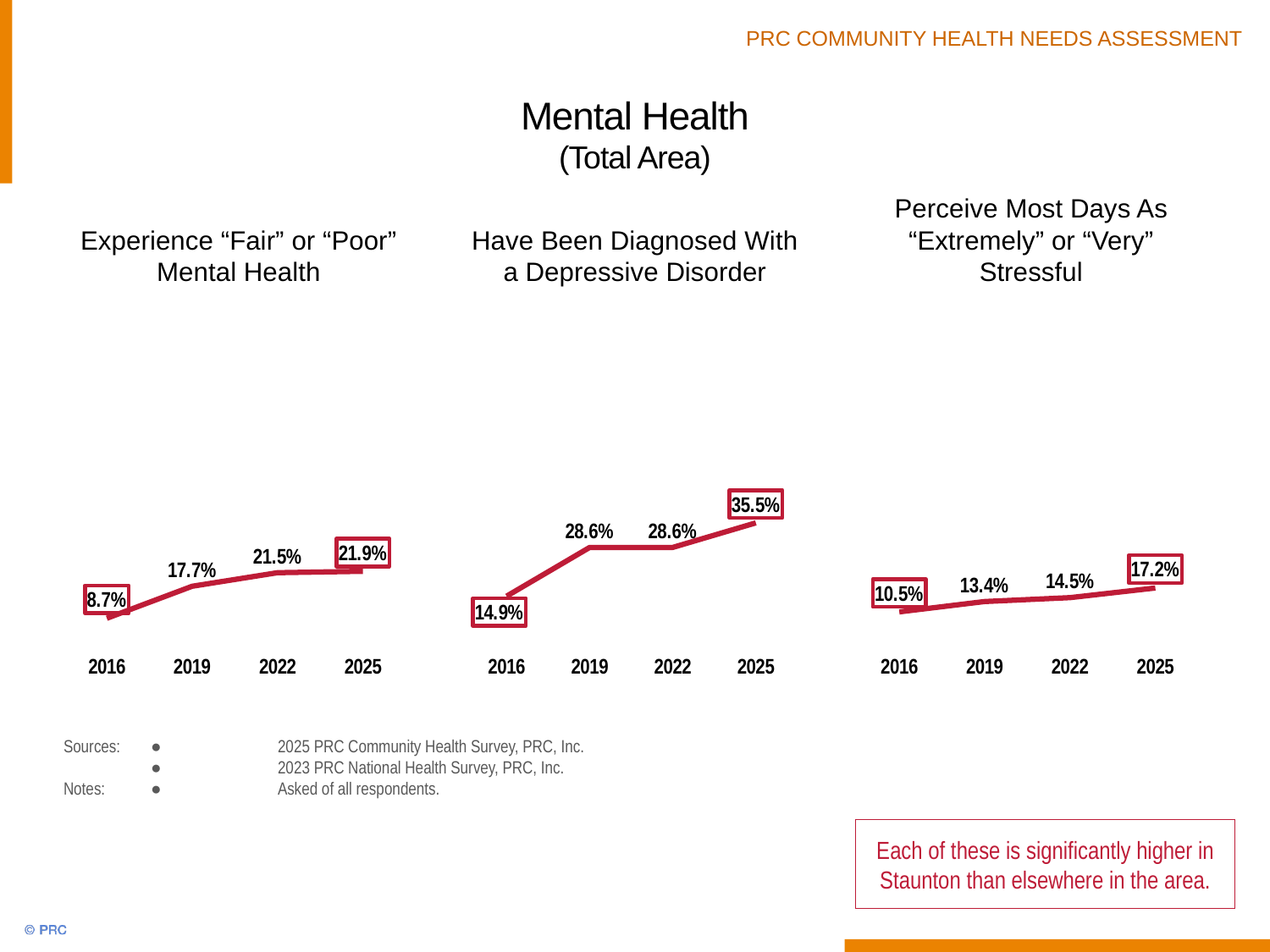
What type of chart is used for "Have Been Diagnosed With a Depressive Disorder"? line chart In the "Perceive Most Days As "Extremely" or "Very" Stressful" chart, what is the value for 2022? 14.5% In the "Have Been Diagnosed With a Depressive Disorder" chart, which year has the highest value? 2025 In the "Experience "Fair" or "Poor" Mental Health" chart, what is the value for 2025? 21.9% In the "Have Been Diagnosed With a Depressive Disorder" chart, what is the difference between the 2025 and 2022 values? 6.9% In the "Experience "Fair" or "Poor" Mental Health" chart, what is the value for 2016? 8.7% In the "Have Been Diagnosed With a Depressive Disorder" chart, which year has the lowest value? 2016 In the "Experience "Fair" or "Poor" Mental Health" chart, is the value for 2019 larger or smaller than the value for 2022? smaller In the "Have Been Diagnosed With a Depressive Disorder" chart, what is the value for 2019? 28.6% How many data points are plotted in the "Perceive Most Days As "Extremely" or "Very" Stressful" chart? 4 In the "Experience "Fair" or "Poor" Mental Health" chart, do the values rise or fall from 2016 to 2025? rise In the "Perceive Most Days As "Extremely" or "Very" Stressful" chart, what is the difference between the 2025 and 2016 values? 6.7%